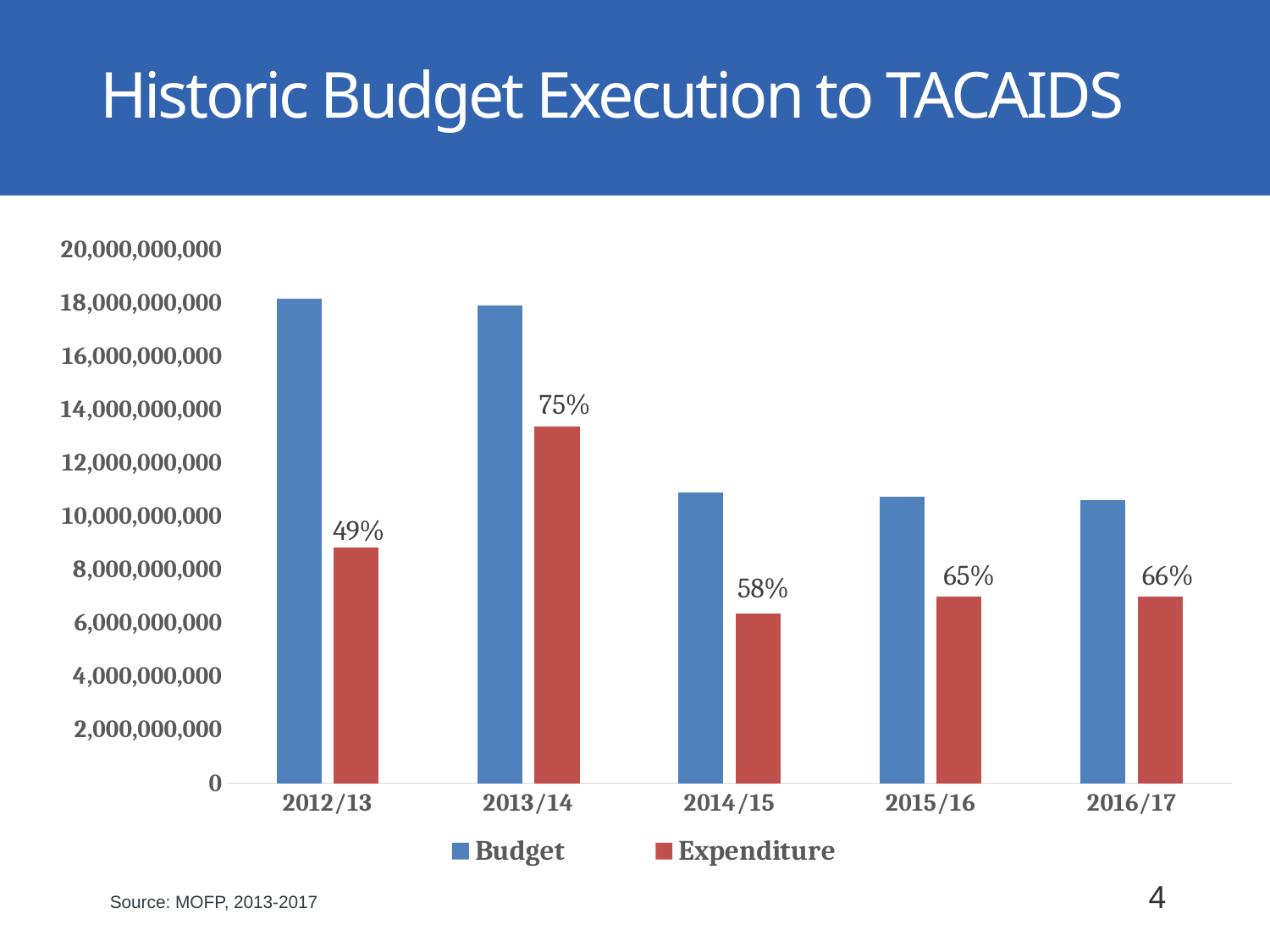
Is the Budget value for 2012/13 greater or less than 16,000,000,000? greater Does the Budget series generally rise or fall from 2012/13 to 2016/17? fall Is the Expenditure value for 2014/15 greater or less than 8,000,000,000? less What percentage label is shown on the Expenditure bar for 2016/17? 66% What is the difference in percentage points between the Expenditure labels for 2013/14 and 2012/13? 26 percentage points What percentage label is shown on the Expenditure bar for 2012/13? 49% How many series does the legend list? 2 In 2015/16, which is larger, the Budget bar or the Expenditure bar? Budget Which fiscal year has the highest percentage label on its Expenditure bar? 2013/14 Which fiscal year has the lowest percentage label on its Expenditure bar? 2012/13 How many fiscal years are shown on the x axis? 5 What percentage label is shown on the Expenditure bar for 2013/14? 75%